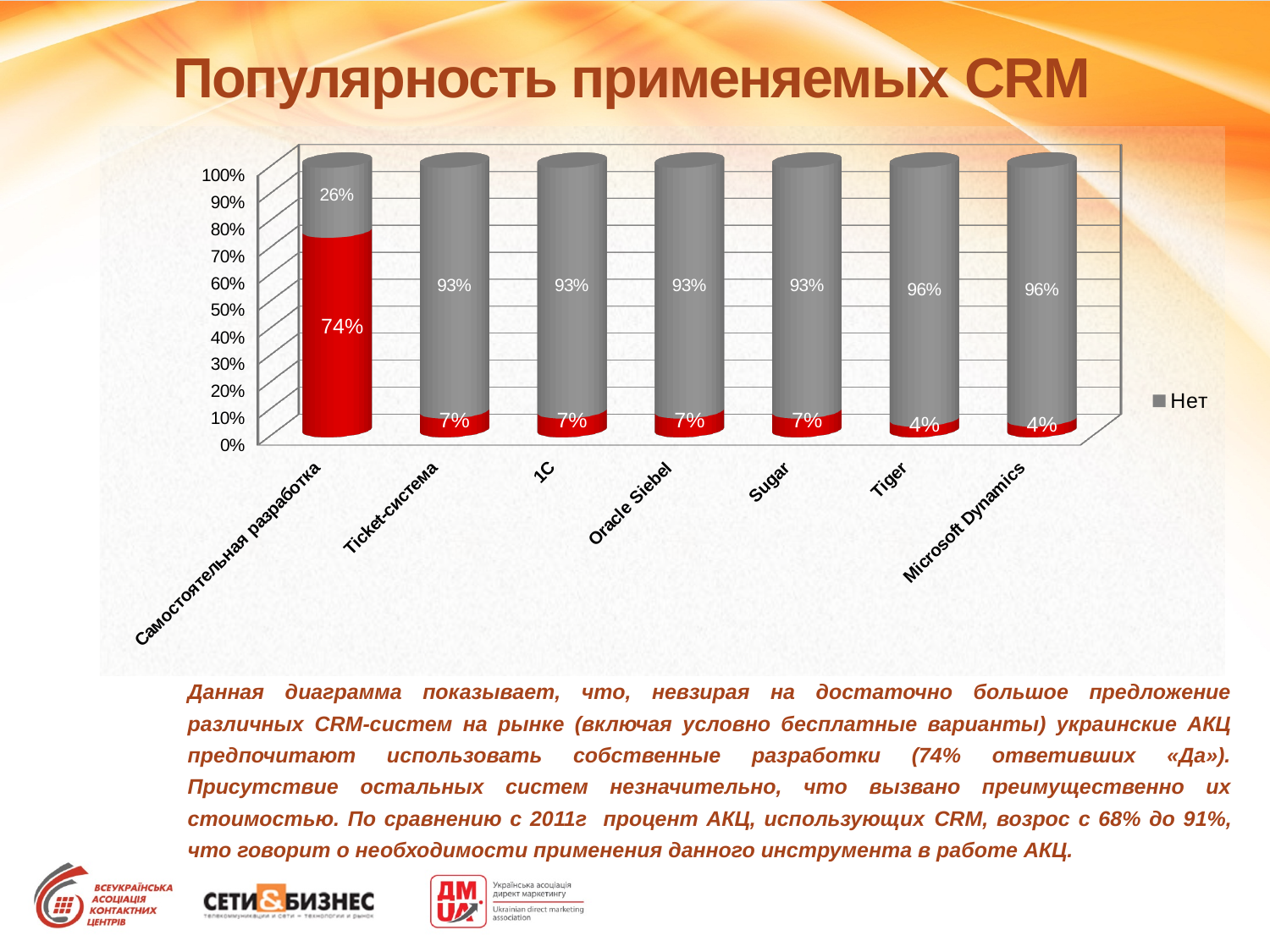
What is the value of the red segment for Самостоятельная разработка? 74% What is the value of the red segment for Microsoft Dynamics? 4% Which category has the lowest value for the grey (Нет) segment? Самостоятельная разработка How many categories are shown on the x axis of the chart? 7 What is the value of the red segment for Oracle Siebel? 7% What kind of chart is shown on the slide? Stacked bar chart Which is larger: the grey (Нет) segment for Sugar or for Tiger? Tiger Which category has the highest value for the red segment? Самостоятельная разработка What is the title of the chart? Популярность применяемых CRM What is the value of the grey (Нет) segment for Tiger? 96% What is the value of the grey (Нет) segment for Самостоятельная разработка? 26% What is the difference between the red segment values for Самостоятельная разработка and Ticket-система? 67%